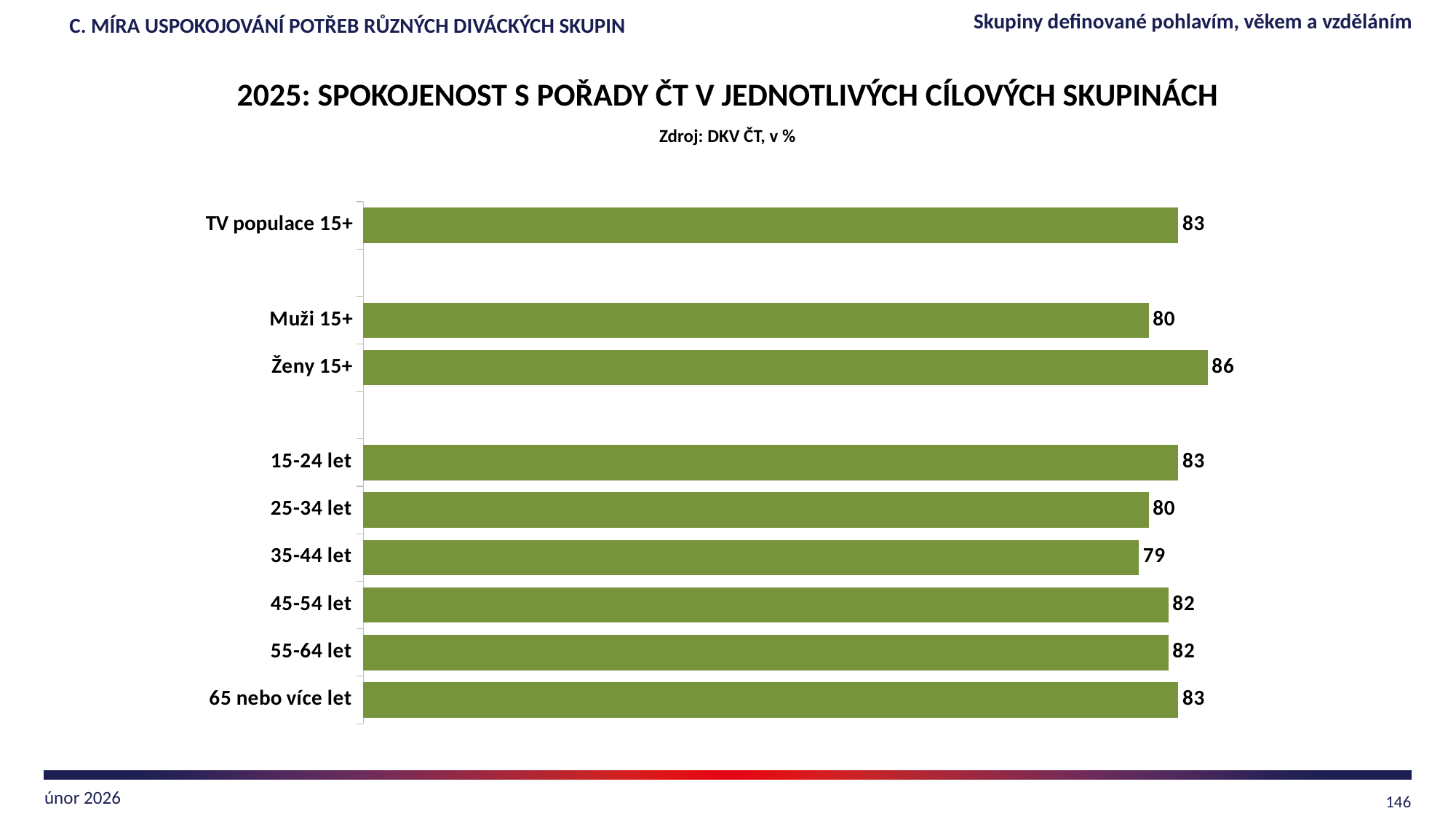
Which category has the lowest value? 35-44 let How many categories are shown in the chart? 9 What is the title of the chart? 2025: SPOKOJENOST S POŘADY ČT V JEDNOTLIVÝCH CÍLOVÝCH SKUPINÁCH What is the value for TV populace 15+? 83 What is the value for 35-44 let? 79 What is the value for Ženy 15+? 86 What is the difference between the values for Ženy 15+ and Muži 15+? 6 What kind of chart is shown on the slide? bar chart Which is larger, the value for 15-24 let or the value for 25-34 let? 15-24 let Which category has the highest value? Ženy 15+ What colour are the bars in the chart? green What is the value for 45-54 let? 82